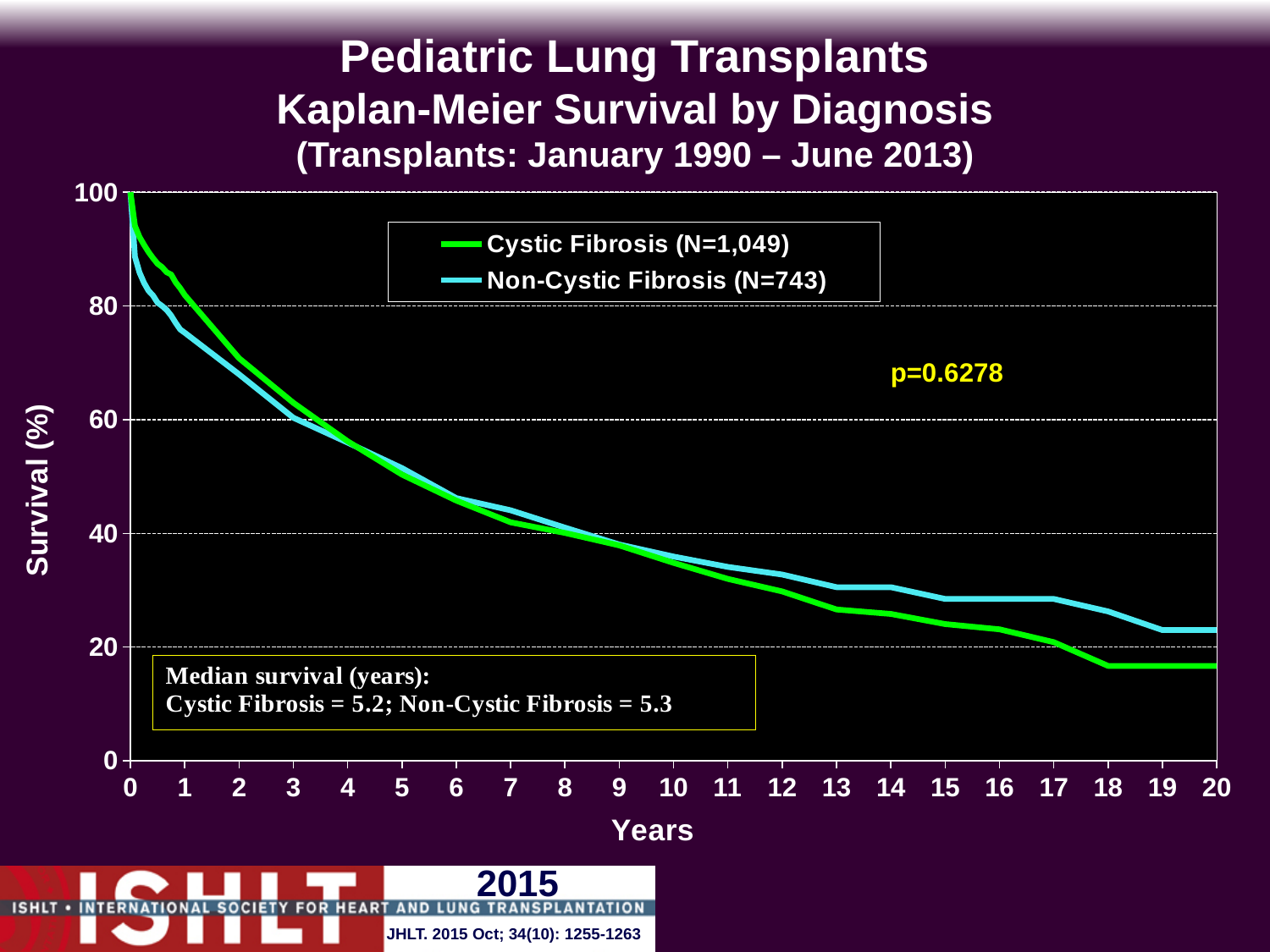
At 20 years, which group has the higher survival, Cystic Fibrosis or Non-Cystic Fibrosis? Non-Cystic Fibrosis Is the survival value for Non-Cystic Fibrosis at 20 years greater or less than 20? greater What is the number of patients (N) in the Non-Cystic Fibrosis group? 743 What p-value is shown on the chart? p=0.6278 What is the number of patients (N) in the Cystic Fibrosis group? 1,049 How many series does the legend list? 2 What is the median survival in years for the Non-Cystic Fibrosis group? 5.3 Do the survival curves rise or fall as years increase? fall How many more patients are in the Cystic Fibrosis group than in the Non-Cystic Fibrosis group? 306 What kind of chart is shown on the slide? line chart Is the survival value for Cystic Fibrosis at 20 years greater or less than 20? less What is the median survival in years for the Cystic Fibrosis group? 5.2